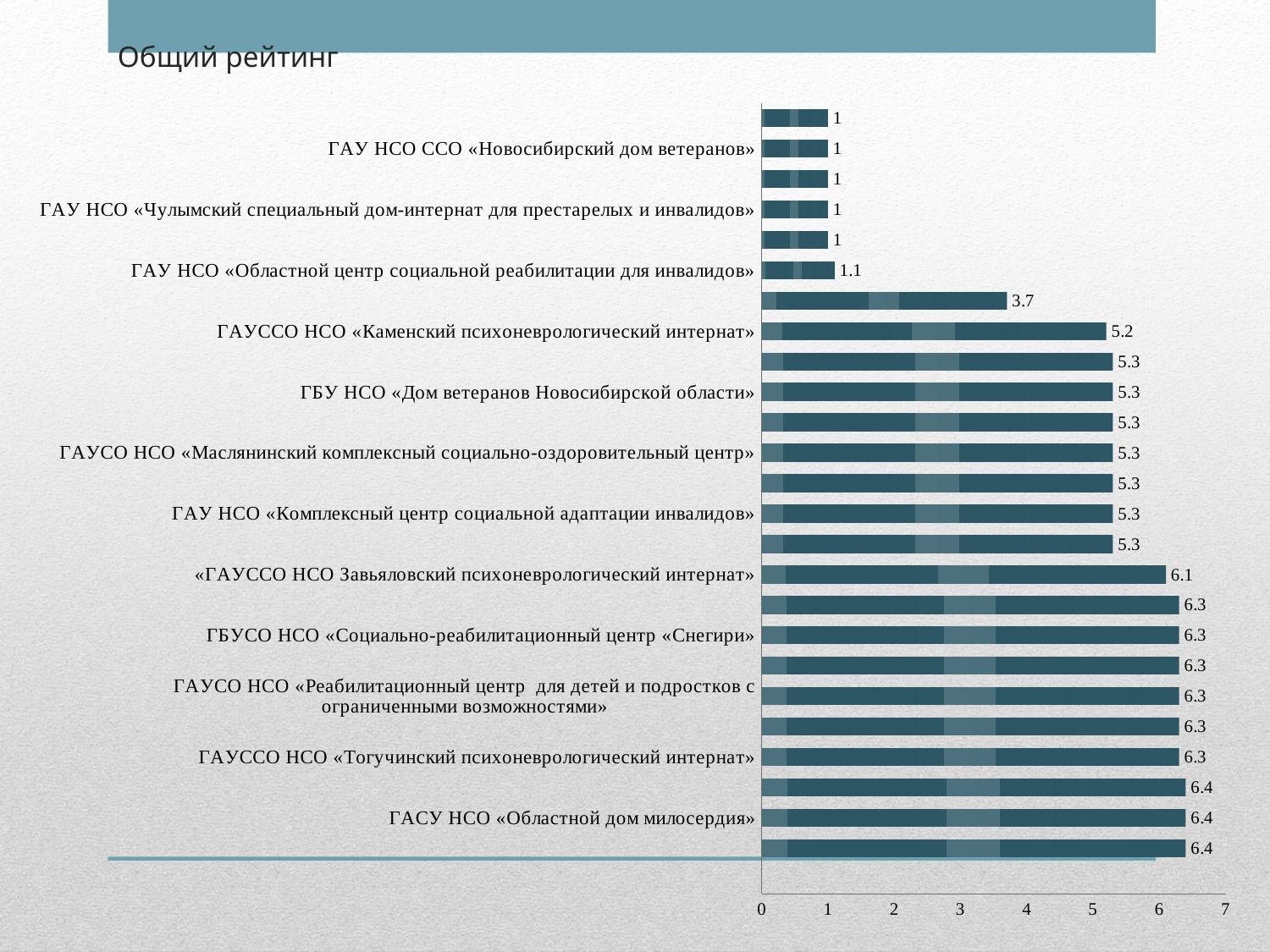
What is the highest value shown on the chart? 6.4 What is the lowest value shown on the chart? 1 What is the value for «ГАУССО НСО Завьяловский психоневрологический интернат»? 6.1 What is the value for ГАУ НСО «Областной центр социальной реабилитации для инвалидов»? 1.1 How many bars are plotted on the chart? 25 What is the value for ГАУ НСО ССО «Новосибирский дом ветеранов»? 1 What is the value for ГАУССО НСО «Каменский психоневрологический интернат»? 5.2 Which has a larger value: ГБУСО НСО «Социально-реабилитационный центр «Снегири» or ГБУ НСО «Дом ветеранов Новосибирской области»? ГБУСО НСО «Социально-реабилитационный центр «Снегири» What is the title of the slide? Общий рейтинг What is the value for ГАСУ НСО «Областной дом милосердия»? 6.4 What kind of chart is shown on the slide? Bar chart What is the difference between the values for ГАСУ НСО «Областной дом милосердия» and ГАУССО НСО «Каменский психоневрологический интернат»? 1.2